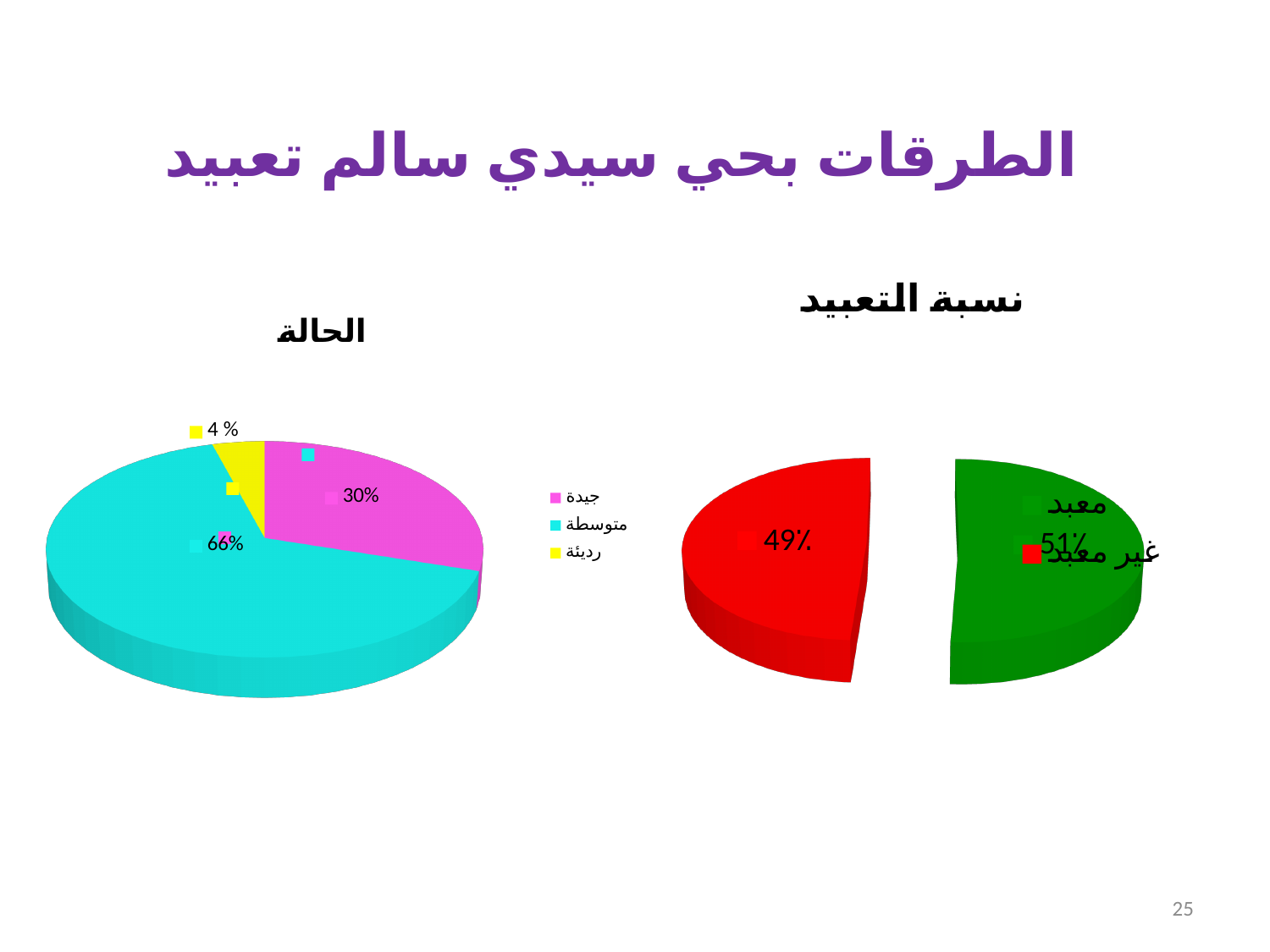
In the chart titled الحالة, what is the difference in percentage points between the متوسطة and جيدة slices? 36 In the chart titled الحالة, what percentage is shown for the متوسطة slice? 66% In the chart titled نسبة التعبيد, what percentage is shown on the red slice? 49% In the chart titled الحالة, what colour is the متوسطة slice? Cyan In the chart titled نسبة التعبيد, what percentage is shown for معبد? 51% In the chart titled الحالة, what percentage is shown for the رديئة slice? 4 % In the chart titled الحالة, which category has the largest slice? متوسطة In the chart titled الحالة, what percentage is shown for the جيدة slice? 30% In the chart titled نسبة التعبيد, which is larger, معبد or غير معبد? معبد In the chart titled الحالة, how many categories does the legend list? 3 In the chart titled الحالة, which category has the smallest slice? رديئة What kind of chart is the chart titled نسبة التعبيد? Pie chart